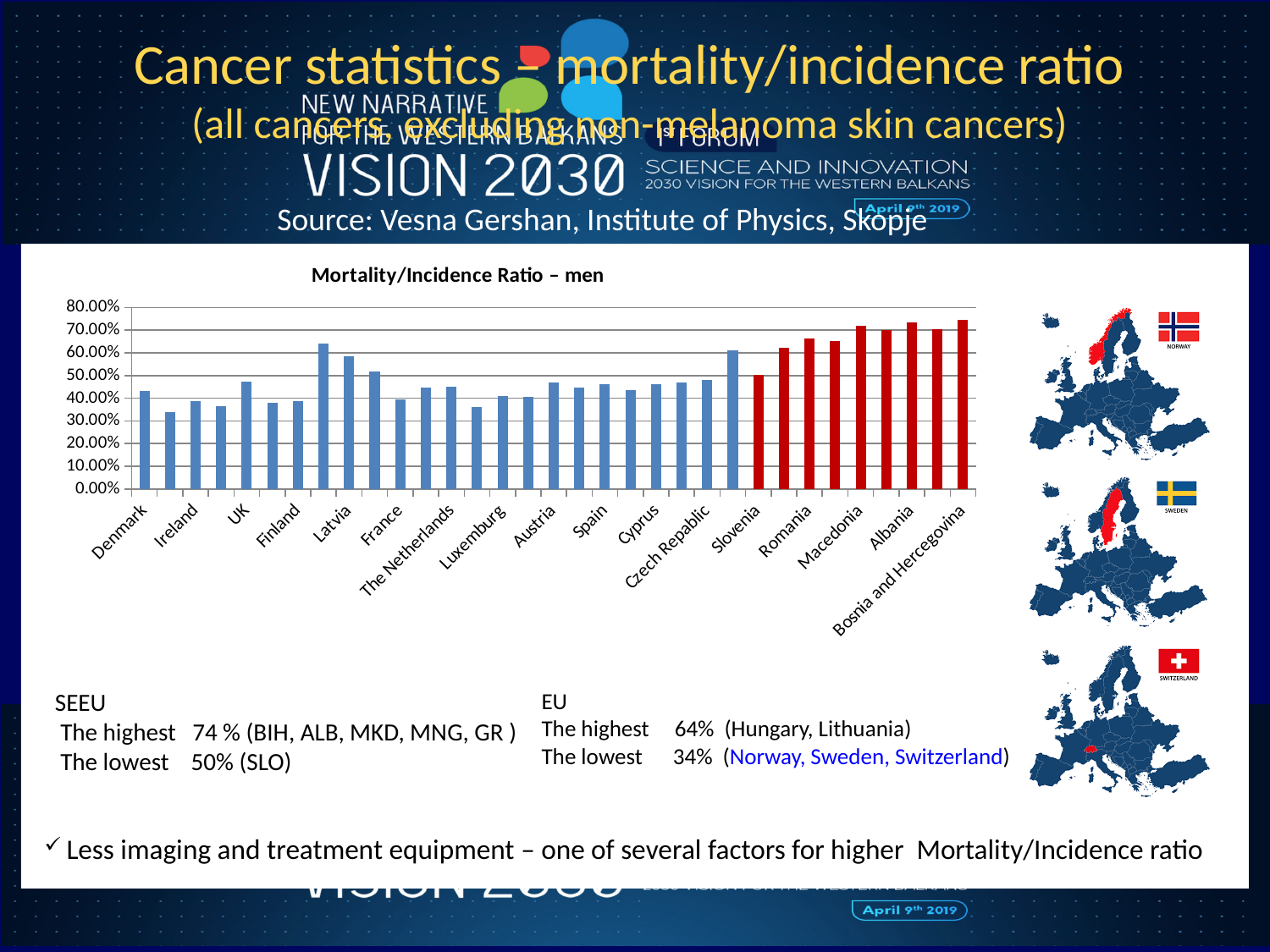
What is the highest value shown on the chart's vertical axis? 80.00% Is the value for Bosnia and Hercegovina greater or less than 70%? greater Is the value for Latvia greater or less than 60%? less Is the value for Ireland greater or less than 40%? less What is the title of the chart? Mortality/Incidence Ratio – men Which has the larger value, Latvia or Denmark? Latvia Which has the larger value, Bosnia and Hercegovina or Slovenia? Bosnia and Hercegovina What kind of chart is shown on the slide? bar chart Which has the larger value, Ireland or Macedonia? Macedonia